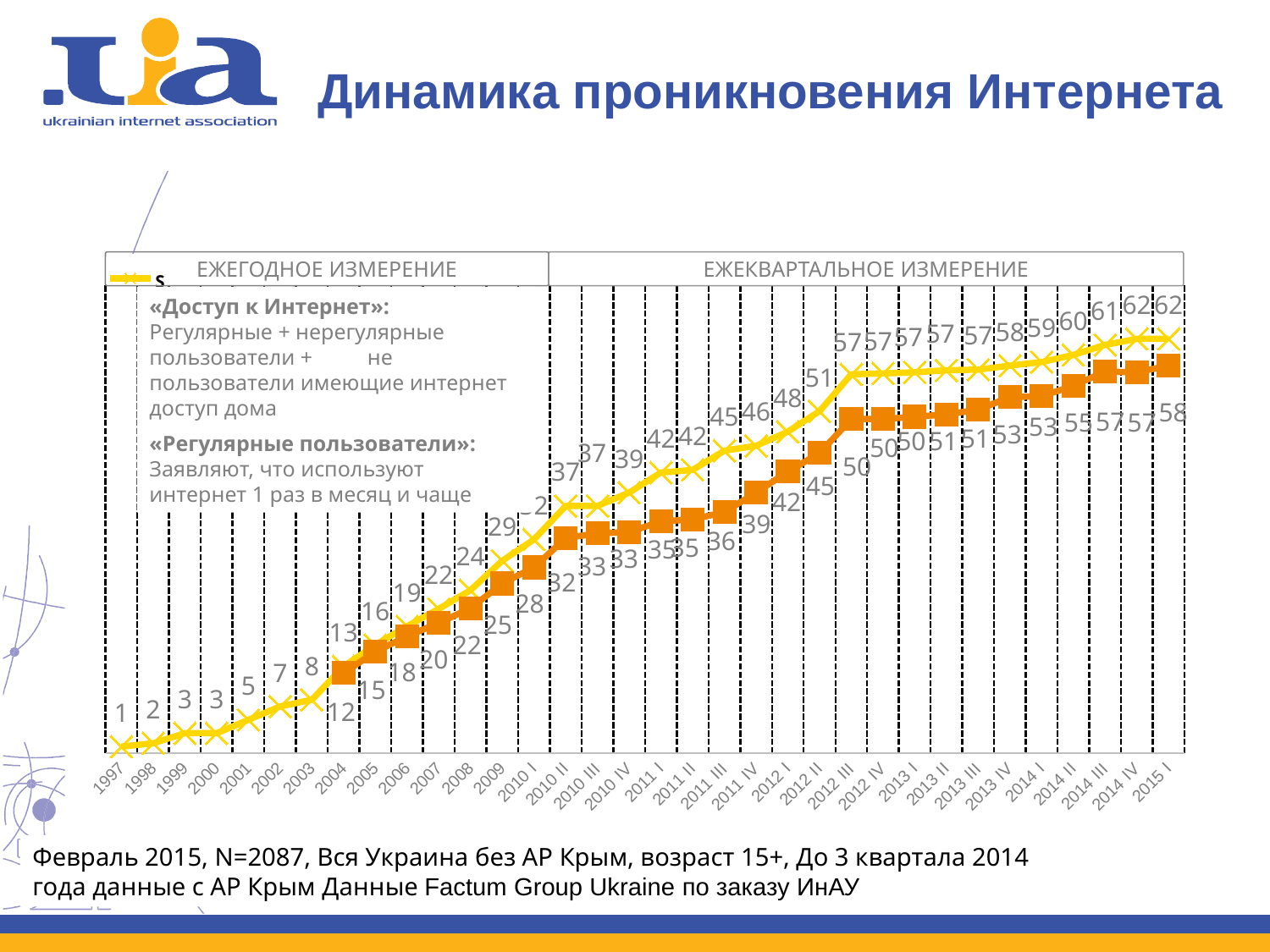
What is the value of the yellow line for 1997? 1 What is the difference between the yellow line and the orange line at 2015 I? 4 What is the title of the slide? Динамика проникновения Интернета What is the value of the orange line (square markers) for 2015 I? 58 What is the value of the yellow line (x markers) for 2015 I? 62 Does the yellow line generally rise or fall from 1997 to 2015 I? rise What is the value of the orange line for 2004? 12 At which point does the orange line reach its highest value? 2015 I At 2012 II, which line has the larger value, the yellow line or the orange line? the yellow line What is the value of the orange line for 2012 I? 42 What kind of chart is shown on the slide? line chart At which point does the yellow line have its lowest value? 1997